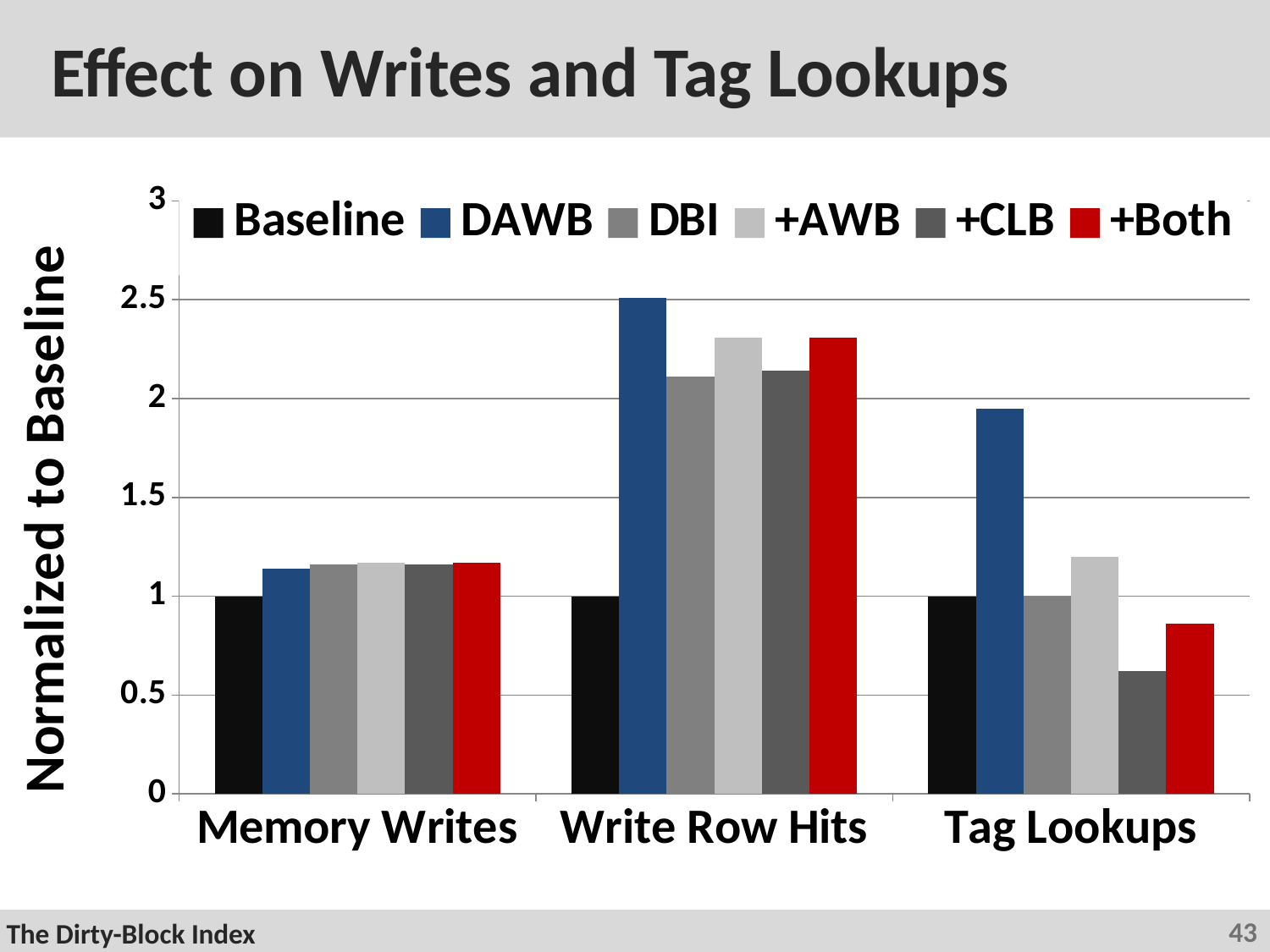
What kind of chart is shown on the slide? bar chart For Tag Lookups, which is larger: the +AWB value or the +Both value? +AWB Which series has the lowest value for Tag Lookups? +CLB What is the Baseline value for Memory Writes? 1 What is the title of the y axis? Normalized to Baseline Is the DAWB value for Write Row Hits greater or less than 2? greater What is the DBI value for Tag Lookups? 1 Is the DAWB value for Tag Lookups greater or less than 1.5? greater Is the +CLB value for Tag Lookups greater or less than 1? less How many categories are shown on the x axis? 3 How many series does the legend list? 6 Which series has the highest value for Write Row Hits? DAWB